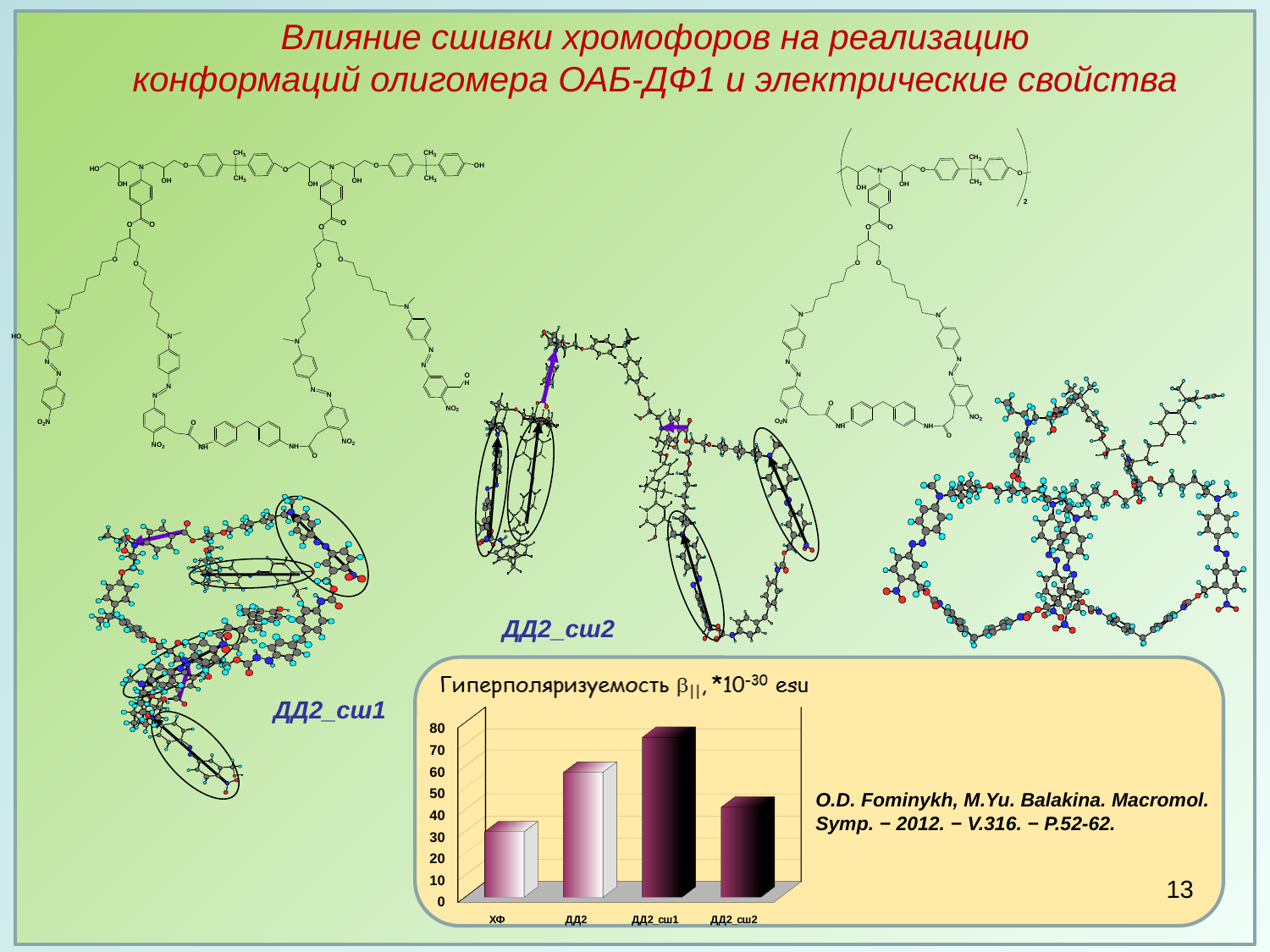
Which category has the highest bar in the chart? ДД2_сш1 Which is larger in the chart, the value for ХФ or the value for ДД2_сш1? ДД2_сш1 What is the maximum value shown on the y axis of the chart? 80 Is the value for ДД2 greater or less than 50? greater Which is larger in the chart, the value for ДД2 or the value for ДД2_сш2? ДД2 What quantity does the chart title say is plotted? Гиперполяризуемость β||, *10-30 esu How many categories are shown on the x axis of the bar chart? 4 Which category has the lowest bar in the chart? ХФ What kind of chart is shown on the slide? bar chart Is the value for ХФ greater or less than 40? less Is the value for ДД2_сш1 greater or less than 70? greater